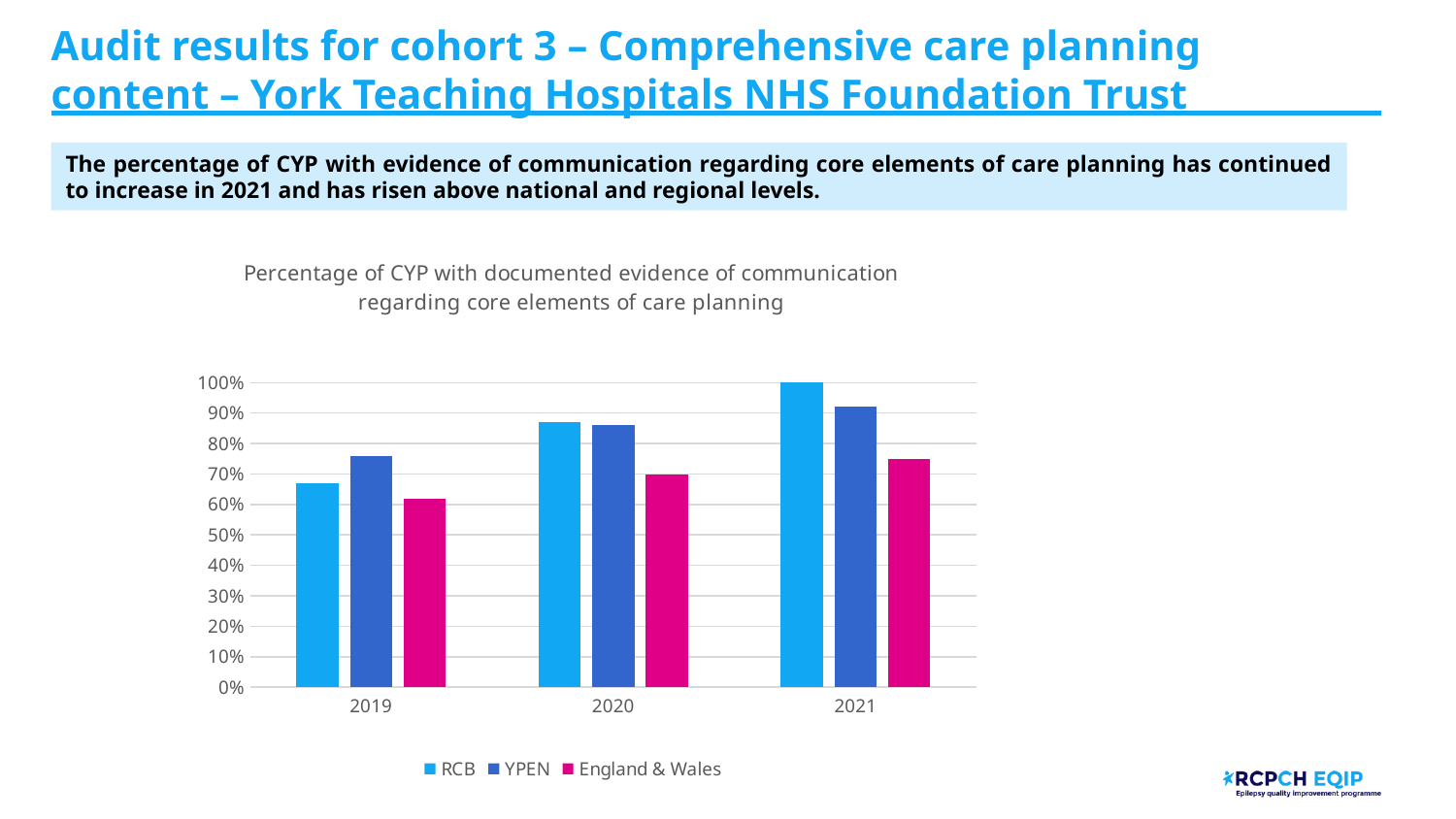
Is the value for RCB in 2019 greater or less than 60%? greater In 2019, which is larger: the value for RCB or the value for YPEN? YPEN How many years are shown on the x axis? 3 Which series has the highest value in 2021? RCB Which series has the lowest value in 2020? England & Wales Do the RCB values rise or fall from 2019 to 2021? rise What is the value for RCB in 2021? 100% Is the value for England & Wales in 2021 greater or less than 80%? less Is the value for YPEN in 2021 greater or less than 90%? greater How many series does the legend list? 3 What kind of chart is shown on the slide? bar chart